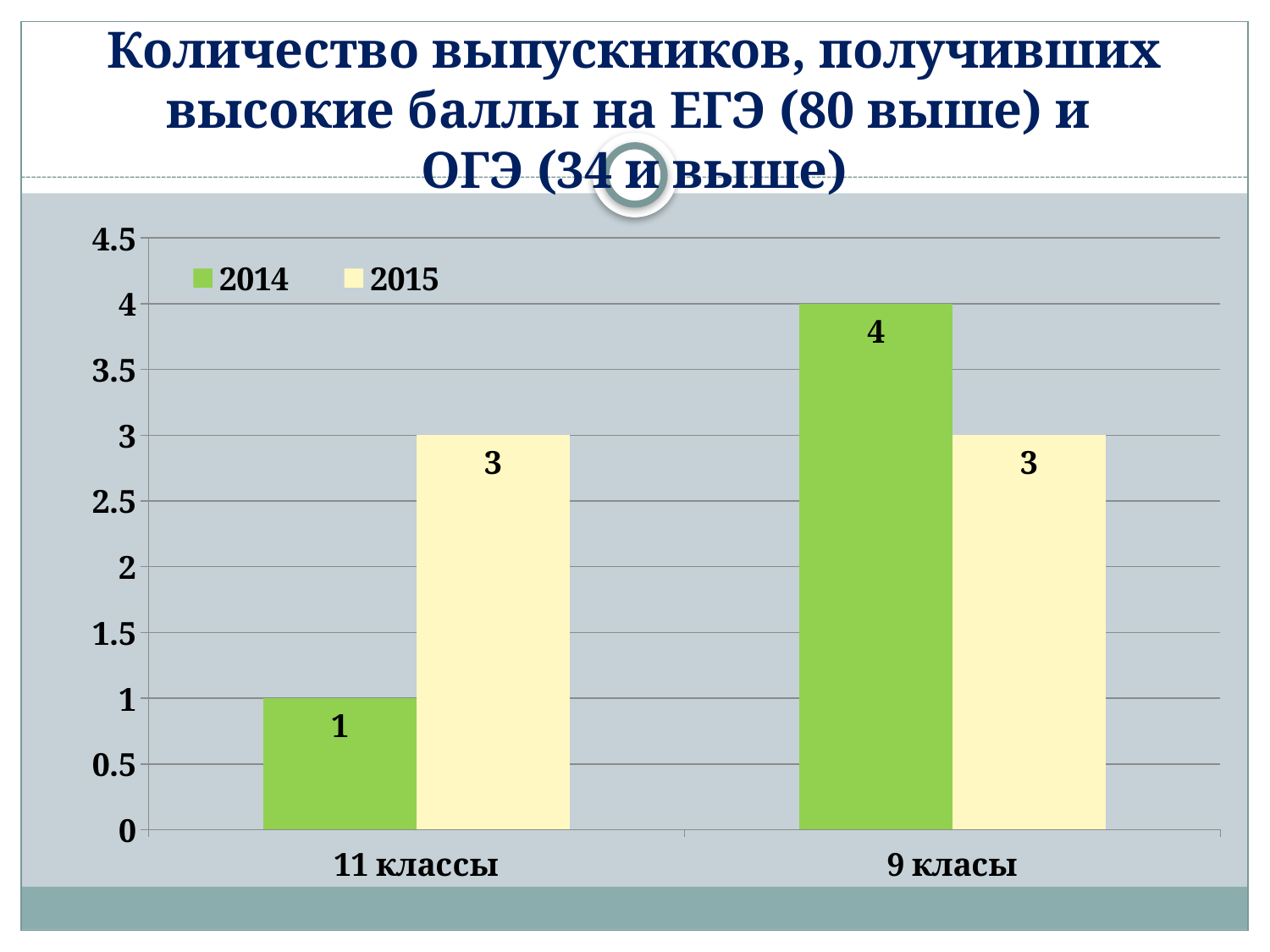
What is the value for 2015 in the 9 класы category? 3 What is the value for 2014 in the 11 классы category? 1 How many series does the legend list? 2 What is the difference between the 2014 and 2015 values for 9 класы? 1 How many categories are shown on the x axis? 2 What is the value for 2014 in the 9 класы category? 4 For 9 класы, which year has the larger value, 2014 or 2015? 2014 Which bar has the lowest value on the chart? 2014, 11 классы Which bar has the highest value on the chart? 2014, 9 класы What is the difference between the 2015 and 2014 values for 11 классы? 2 What kind of chart is shown on the slide? bar chart What is the value for 2015 in the 11 классы category? 3